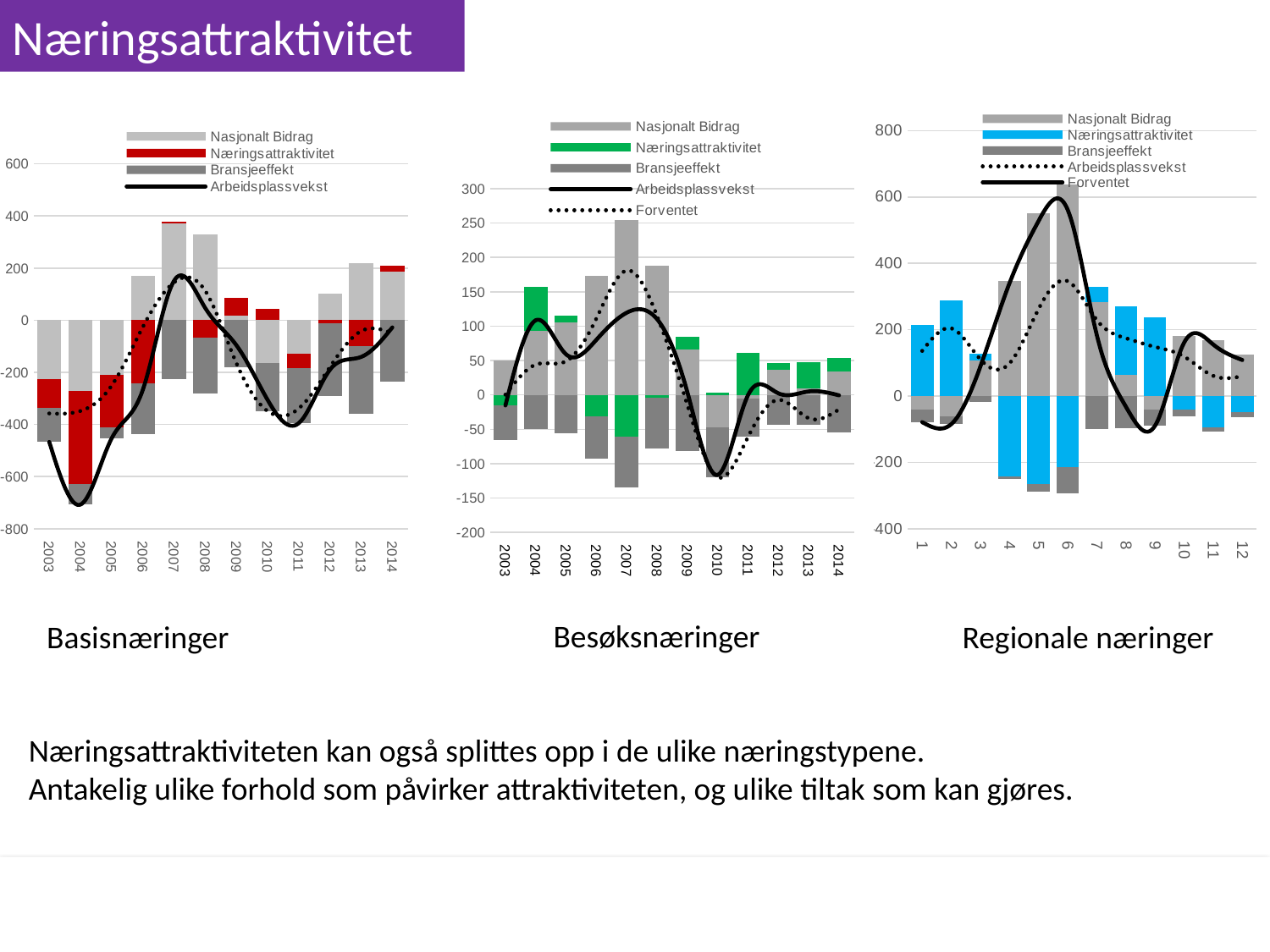
In the Regionale næringer chart, is the Nasjonalt Bidrag value for category 6 greater or less than 400? greater How many series does the legend of the Basisnæringer chart list? 4 How many categories are shown on the x axis of the Regionale næringer chart? 12 In the Besøksnæringer chart, is the Nasjonalt Bidrag value for 2007 greater or less than 200? greater What kind of chart is the Basisnæringer chart on the left? bar chart with line overlays In the Besøksnæringer chart, which is larger, the Nasjonalt Bidrag bar for 2007 or for 2008? 2007 In the Regionale næringer chart, which category has the tallest Nasjonalt Bidrag bar? 6 In the Besøksnæringer chart, which year has the tallest Nasjonalt Bidrag bar? 2007 In the Basisnæringer chart, is the Nasjonalt Bidrag value for 2007 greater or less than 200? greater How many series does the legend of the Besøksnæringer chart list? 5 In the Regionale næringer chart, does the Arbeidsplassvekst line rise or fall from category 1 to category 6? rise What colour represents Næringsattraktivitet in the Regionale næringer chart? blue